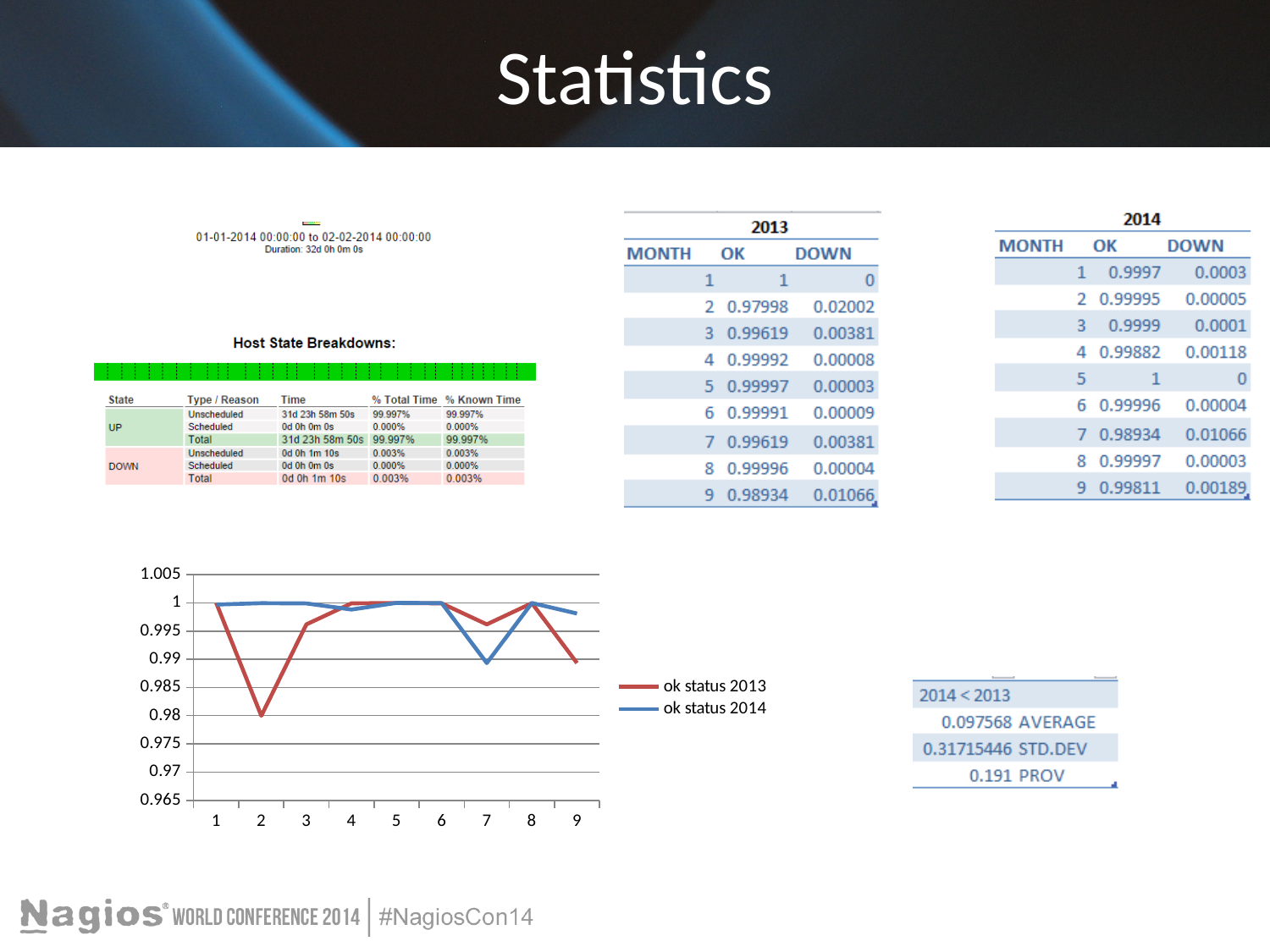
How many points are plotted along the x axis for each series in the chart? 9 At month 2, which series has the larger value, ok status 2013 or ok status 2014? ok status 2014 At which month does the ok status 2013 series reach its lowest value? 2 At which month does the ok status 2014 series reach its lowest value? 7 Is the value of ok status 2013 at month 2 greater or less than 0.985? less What kind of chart is shown on the slide? line chart Does the ok status 2013 series rise or fall from month 1 to month 2? fall Which colour is used for the ok status 2013 series in the chart? red How many series does the chart legend list? 2 What are the two series named in the chart legend? ok status 2013 and ok status 2014 What is the value of the ok status 2013 series at month 1? 1